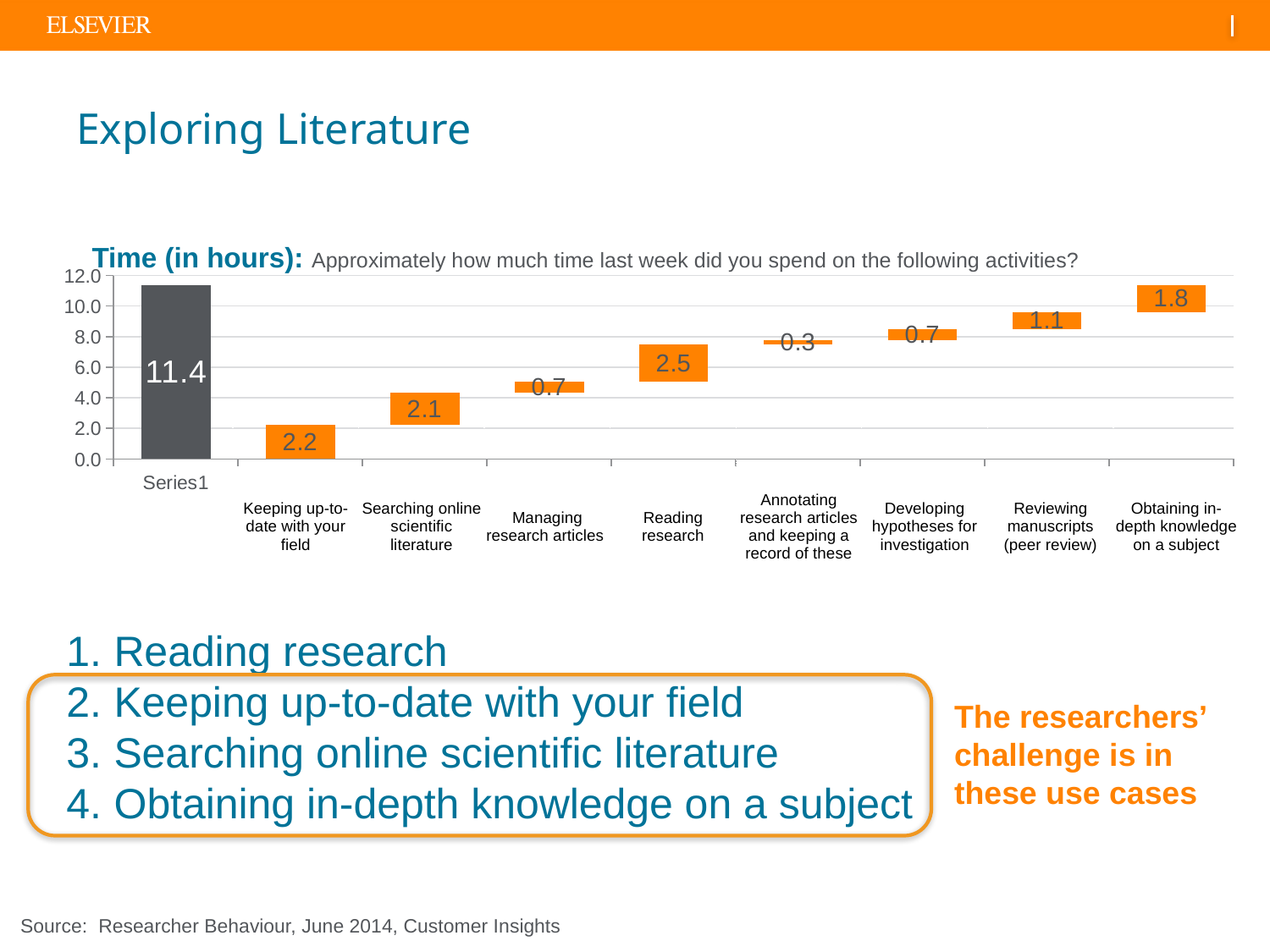
What is the value shown for Obtaining in-depth knowledge on a subject? 1.8 How many activity categories are shown on the x axis, excluding Series1? 8 What is the value shown for Keeping up-to-date with your field? 2.2 Which activity has the highest number of hours? Reading research What kind of chart is shown on the slide? bar chart Is the value of the Series1 bar greater or less than 10.0? greater What is the value shown for the Series1 bar? 11.4 Which activity has the lowest number of hours? Annotating research articles and keeping a record of these What is the value shown for Reading research? 2.5 What is the difference in hours between Reading research and Keeping up-to-date with your field? 0.3 Which has a larger value, Reviewing manuscripts (peer review) or Developing hypotheses for investigation? Reviewing manuscripts (peer review) What is the value shown for Annotating research articles and keeping a record of these? 0.3